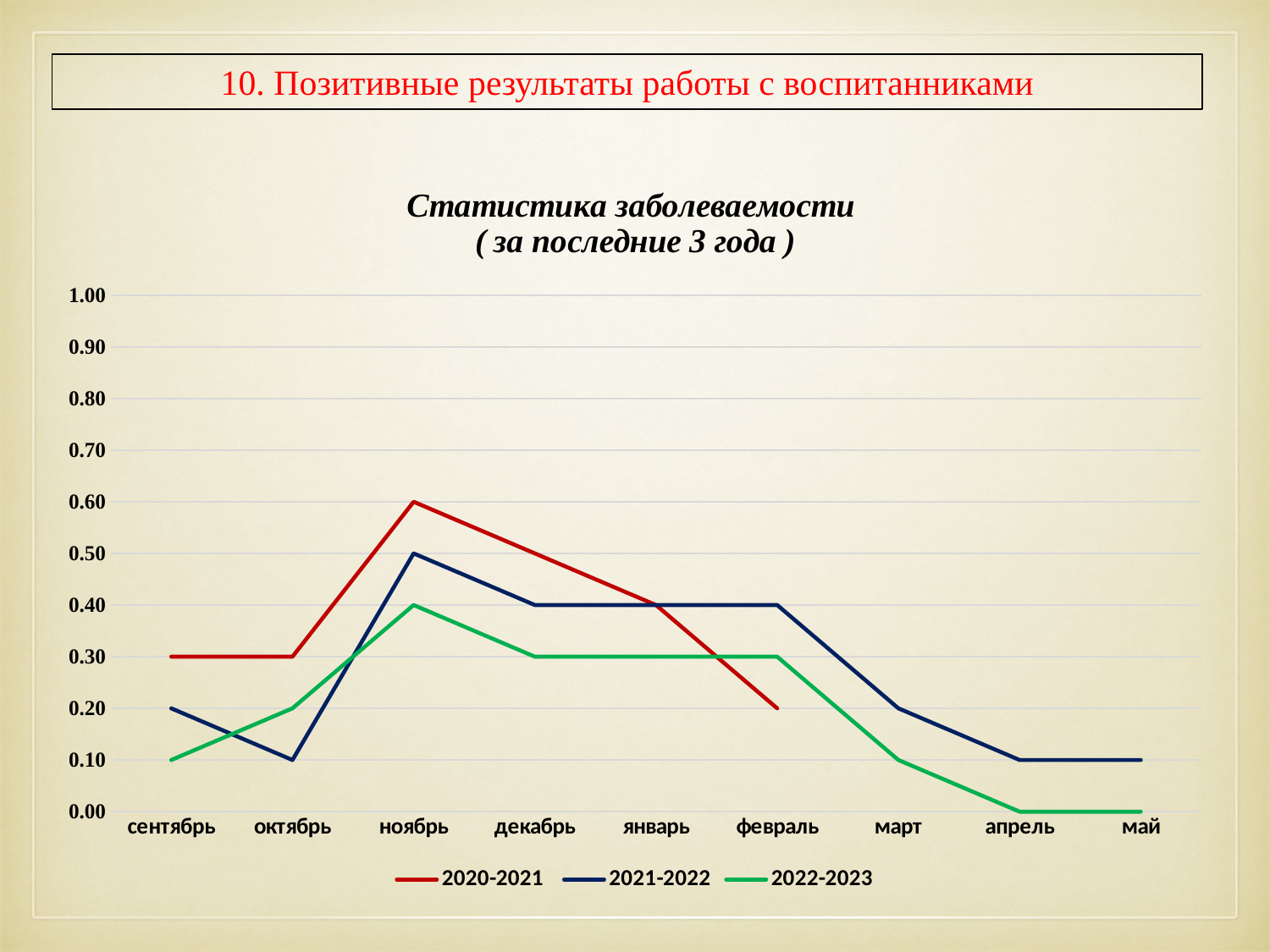
Which series has the higher value in сентябрь, 2021-2022 or 2022-2023? 2021-2022 In which month does the 2021-2022 series reach its highest value? ноябрь Does the 2022-2023 series rise or fall from февраль to апрель? fall In which month does the 2020-2021 series have its lowest value? февраль What is the difference between the 2020-2021 and 2022-2023 values in ноябрь? 0.20 What is the value for 2020-2021 in ноябрь? 0.60 What is the title of the chart? Статистика заболеваемости ( за последние 3 года ) What is the value for 2021-2022 in октябрь? 0.10 How many series does the legend list? 3 How many months are shown on the x axis? 9 What kind of chart is shown on the slide? line chart What is the value for 2022-2023 in май? 0.00